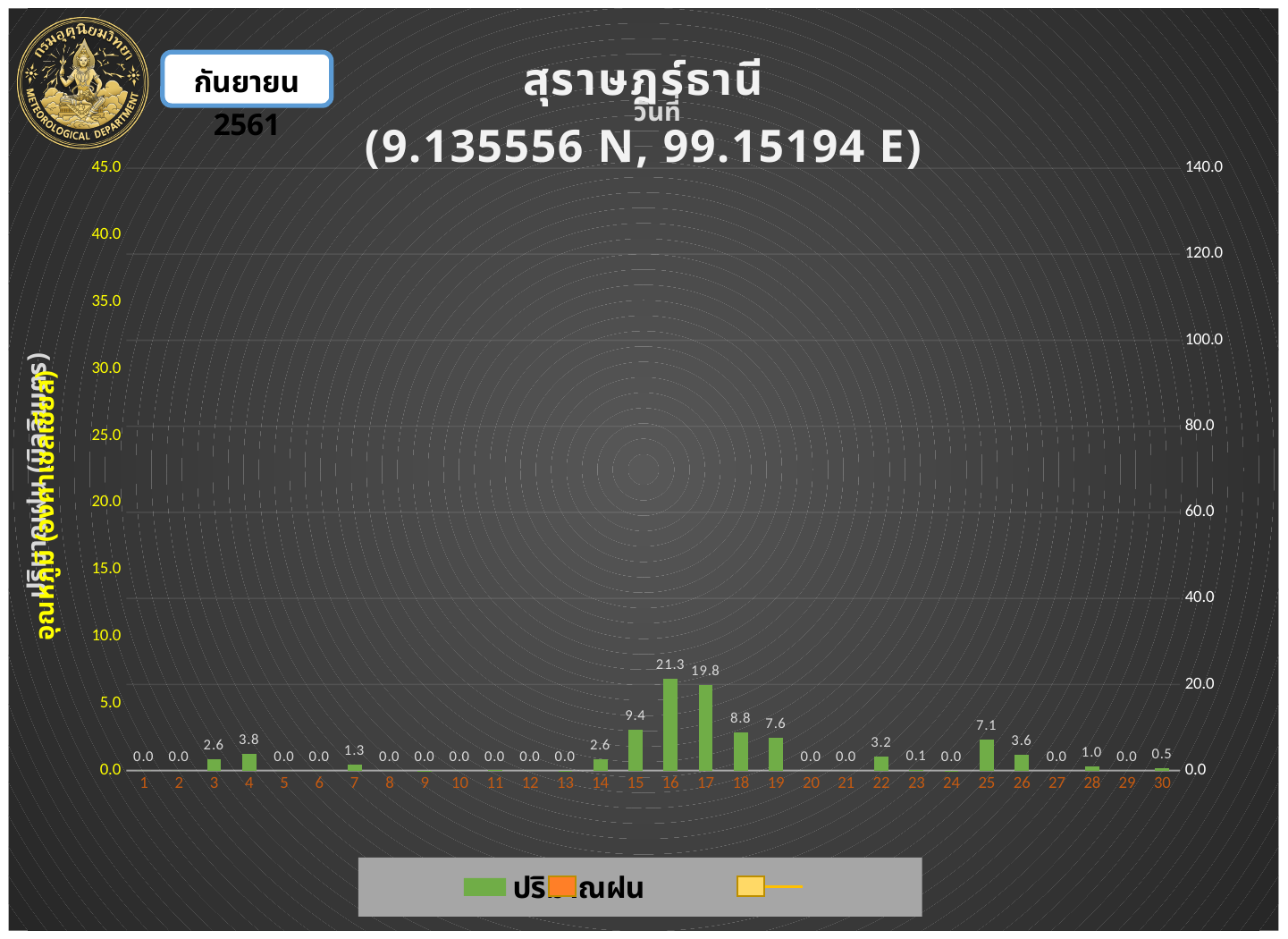
Which day has the highest rainfall value? 16 What coordinates are given in the chart title? 9.135556 N, 99.15194 E What is the rainfall value shown for day 16? 21.3 What is the difference between the rainfall values for day 15 and day 18? 0.6 What is the rainfall value shown for day 17? 19.8 What kind of chart is shown on the slide? bar chart Which is larger, the rainfall value for day 19 or for day 25? day 19 How many days are shown on the x axis? 30 What is the rainfall value shown for day 4? 3.8 What is the rainfall value shown for day 25? 7.1 Which is larger, the rainfall value for day 22 or for day 26? day 26 What is the difference between the rainfall values for day 16 and day 17? 1.5